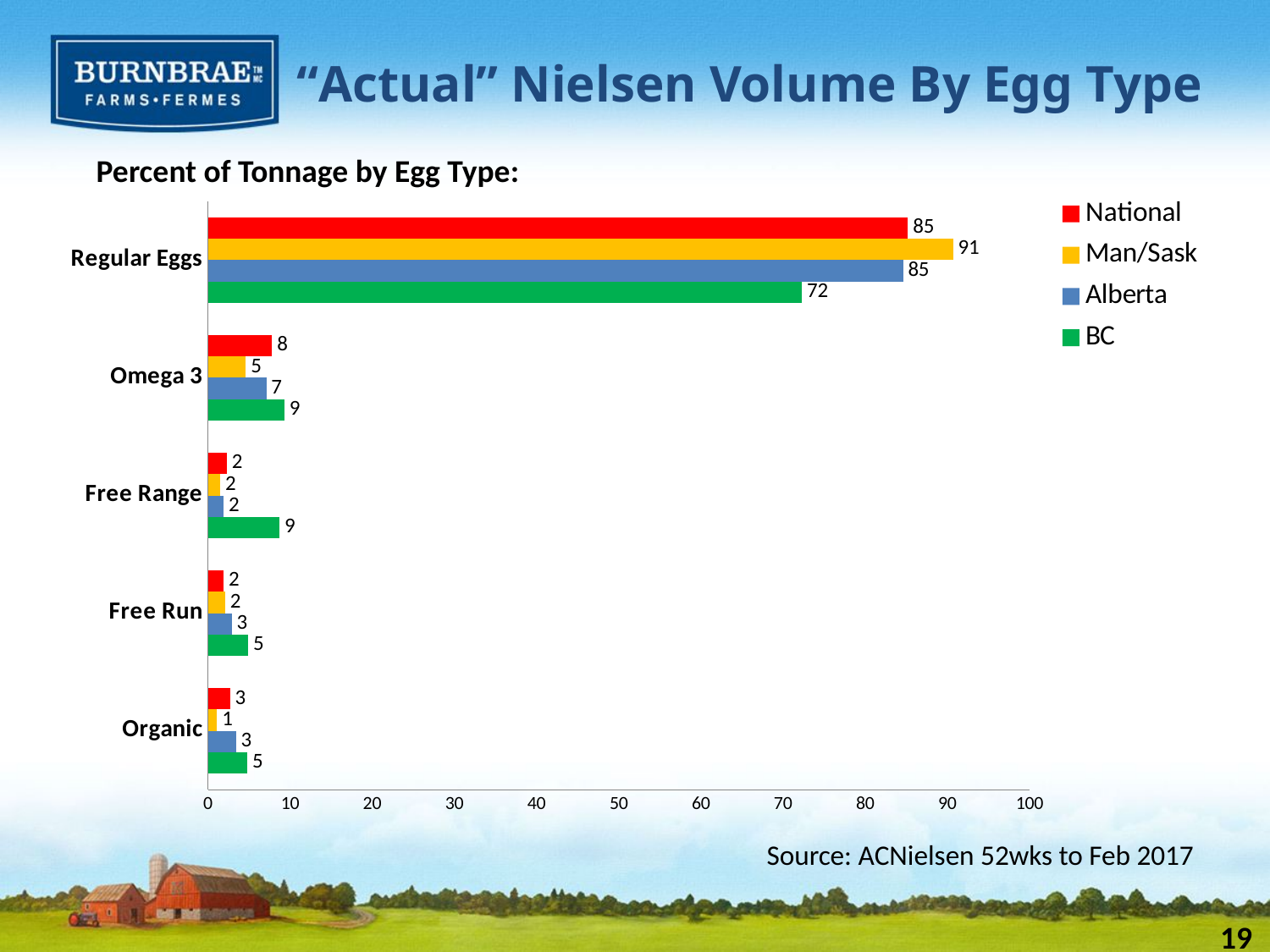
What is the BC value for Regular Eggs? 72 What is the Alberta value for Free Run? 3 What is the Man/Sask value for Regular Eggs? 91 How many series does the legend list? 4 Which is larger for Free Range: the BC value or the National value? BC Which region has the highest value for Regular Eggs? Man/Sask How many egg type categories are shown on the chart? 5 What kind of chart is shown on the slide? bar chart Which region has the lowest value for Organic? Man/Sask What is the National value for Omega 3? 8 Is the BC value for Regular Eggs greater or less than 80? less What is the difference between the Man/Sask and BC values for Regular Eggs? 19